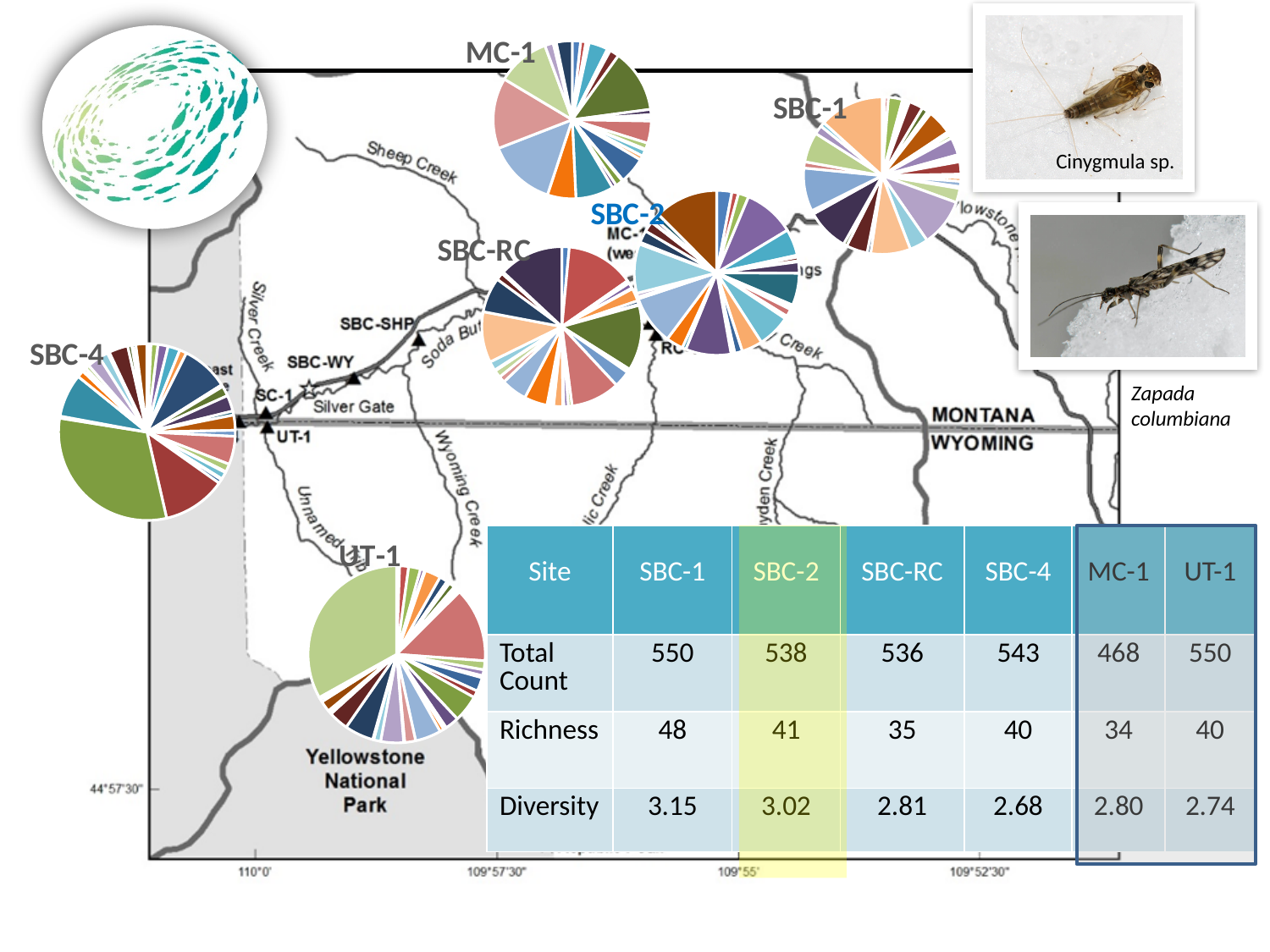
Which is larger: the largest slice of the SBC-4 pie chart or the largest slice of the MC-1 pie chart? SBC-4 Which pie chart's label is written in blue rather than grey? SBC-2 What kind of chart is the MC-1 chart? pie chart What colour is the largest slice in the SBC-4 pie chart? green How many pie charts are shown on the slide? 6 Which is larger: the largest slice of the UT-1 pie chart or the largest slice of the SBC-1 pie chart? UT-1